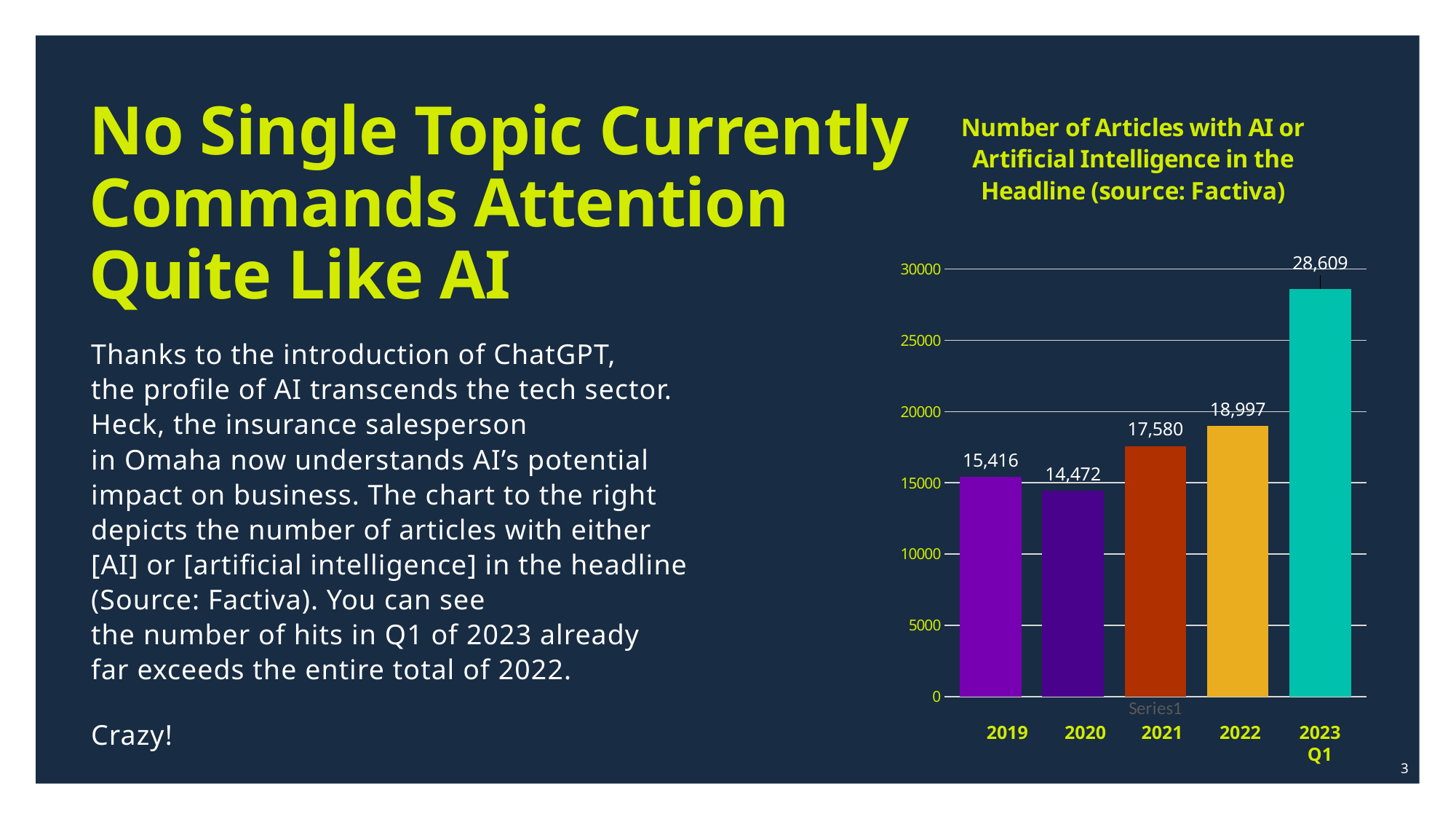
What is the number of articles for 2023 Q1? 28,609 Which period has the lowest number of articles? 2020 Which period has the highest number of articles? 2023 Q1 What is the title of the chart? Number of Articles with AI or Artificial Intelligence in the Headline (source: Factiva) How many periods are shown on the x axis of the chart? 5 What is the number of articles for 2021? 17,580 What kind of chart is shown on the slide? Bar chart What is the number of articles for 2020? 14,472 What is the number of articles for 2019? 15,416 What is the difference between the number of articles in 2023 Q1 and in 2022? 9,612 What is the number of articles for 2022? 18,997 Which has more articles, 2019 or 2020? 2019